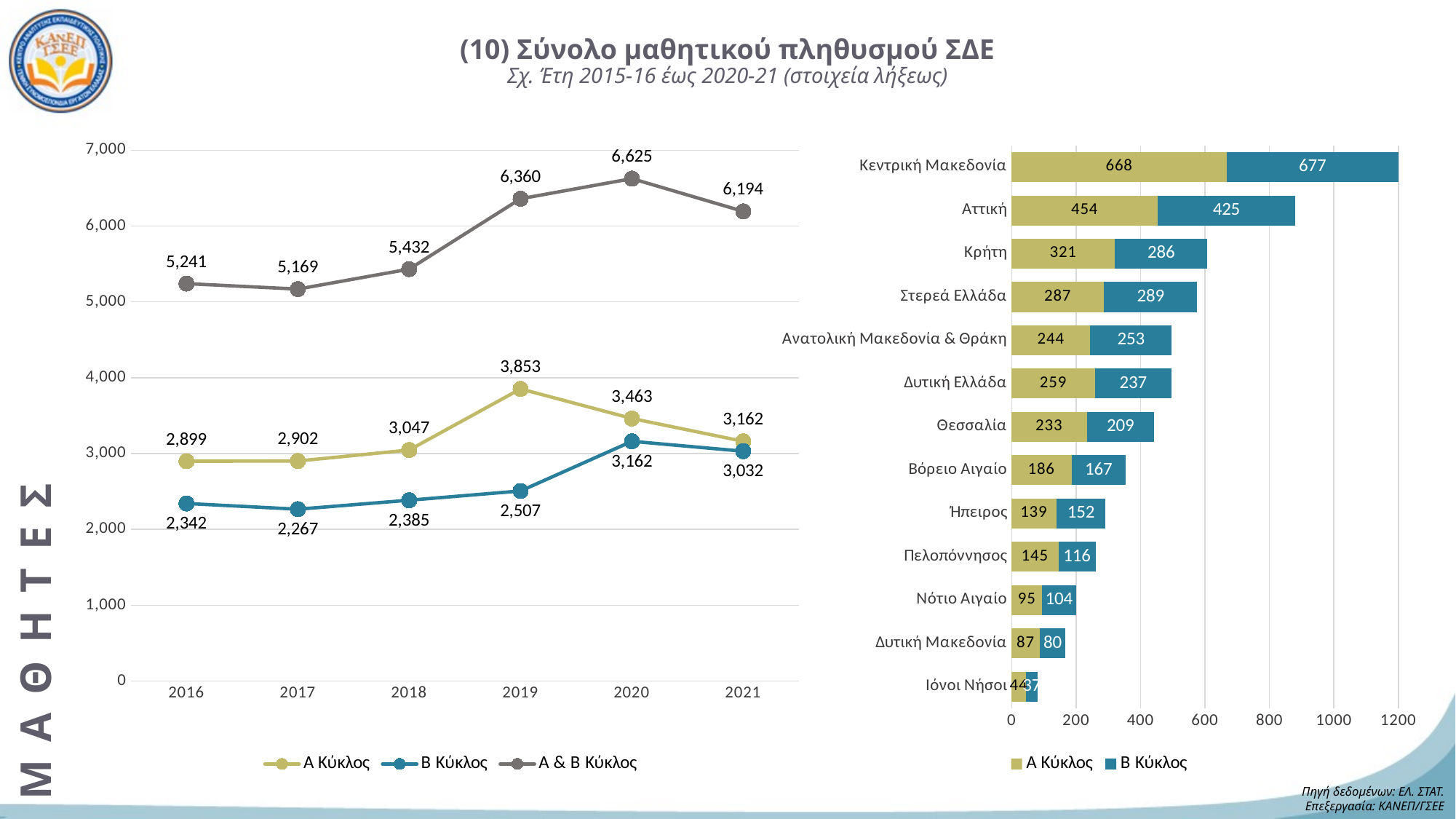
In the line chart on the left, in which year is Α & Β Κύκλος lowest? 2017 In the bar chart on the right, which is larger for Θεσσαλία: Α Κύκλος or Β Κύκλος? Α Κύκλος What kind of chart is shown on the right side of the slide? stacked bar chart In the line chart on the left, does Α & Β Κύκλος rise or fall from 2018 to 2019? rise In the line chart on the left, what is the difference between Α Κύκλος and Β Κύκλος in 2019? 1,346 In the line chart on the left, what is the value of Α & Β Κύκλος in 2020? 6,625 In the line chart on the left, how many series does the legend list? 3 In the bar chart on the right, what is the total of the stacked bar for Κρήτη? 607 In the bar chart on the right, what is the Β Κύκλος value for Αττική? 425 In the line chart on the left, in which year does Α Κύκλος reach its highest value? 2019 In the line chart on the left, what is the value of Β Κύκλος in 2017? 2,267 In the bar chart on the right, which region has the highest Α Κύκλος value? Κεντρική Μακεδονία